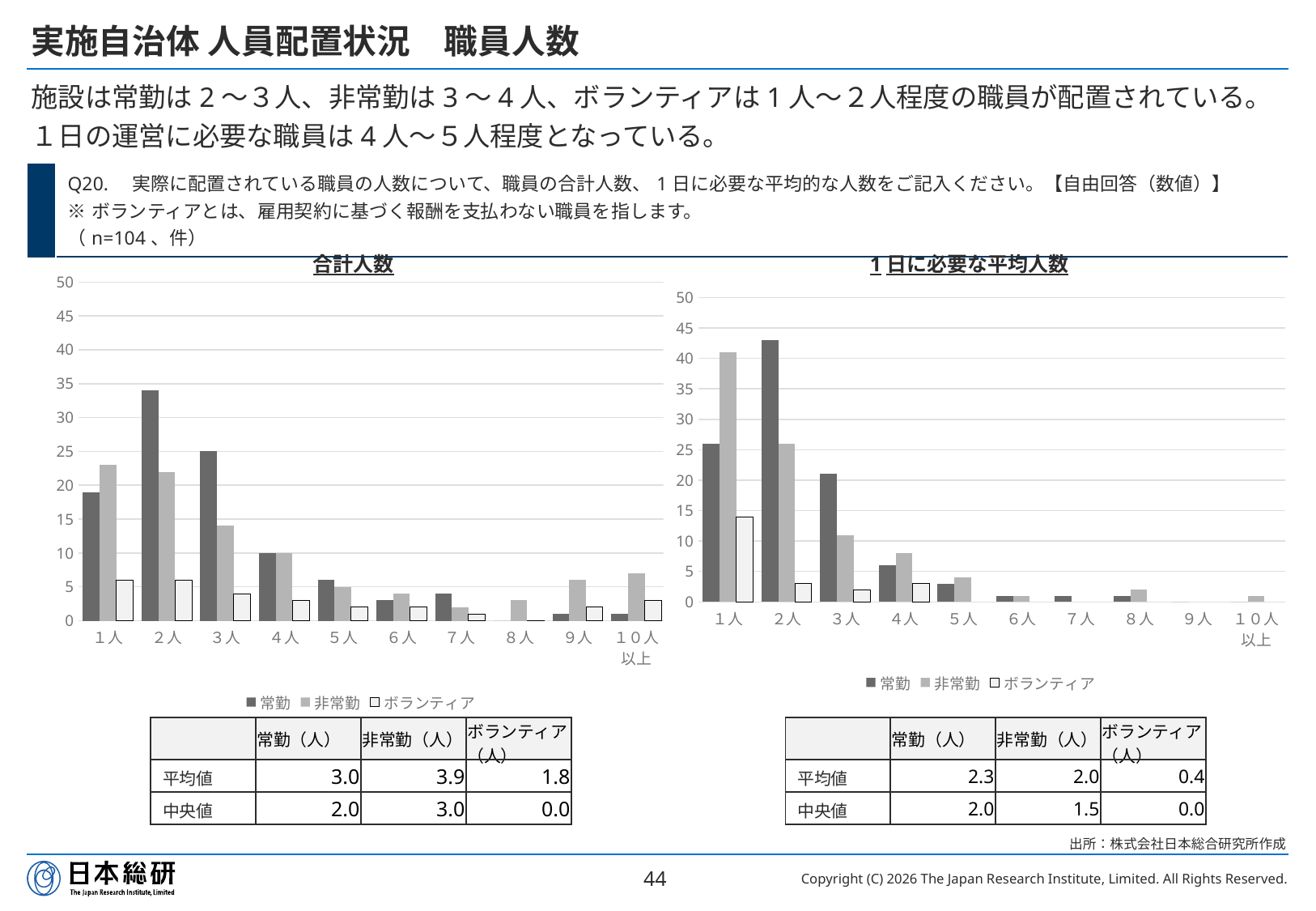
In the right chart (1日に必要な平均人数), which category has the tallest 非常勤 bar? 1人 In the left chart (合計人数), is the 常勤 value for 2人 greater or less than 30? greater In the right chart (1日に必要な平均人数), how many categories are shown on the x axis? 10 What is the title of the chart on the right side of the slide? 1日に必要な平均人数 In the left chart (合計人数), for the category 1人, which is larger: 常勤 or 非常勤? 非常勤 In the right chart (1日に必要な平均人数), do the 常勤 values rise or fall from 2人 to 10人以上? fall In the right chart (1日に必要な平均人数), which category has the tallest 常勤 bar? 2人 In the right chart (1日に必要な平均人数), is the 非常勤 value for 1人 greater or less than 35? greater In the left chart (合計人数), how many series does the legend list? 3 What kind of chart is the left chart titled 合計人数? bar chart In the right chart (1日に必要な平均人数), for the category 2人, which is larger: 常勤 or 非常勤? 常勤 In the left chart (合計人数), which category has the tallest 常勤 bar? 2人